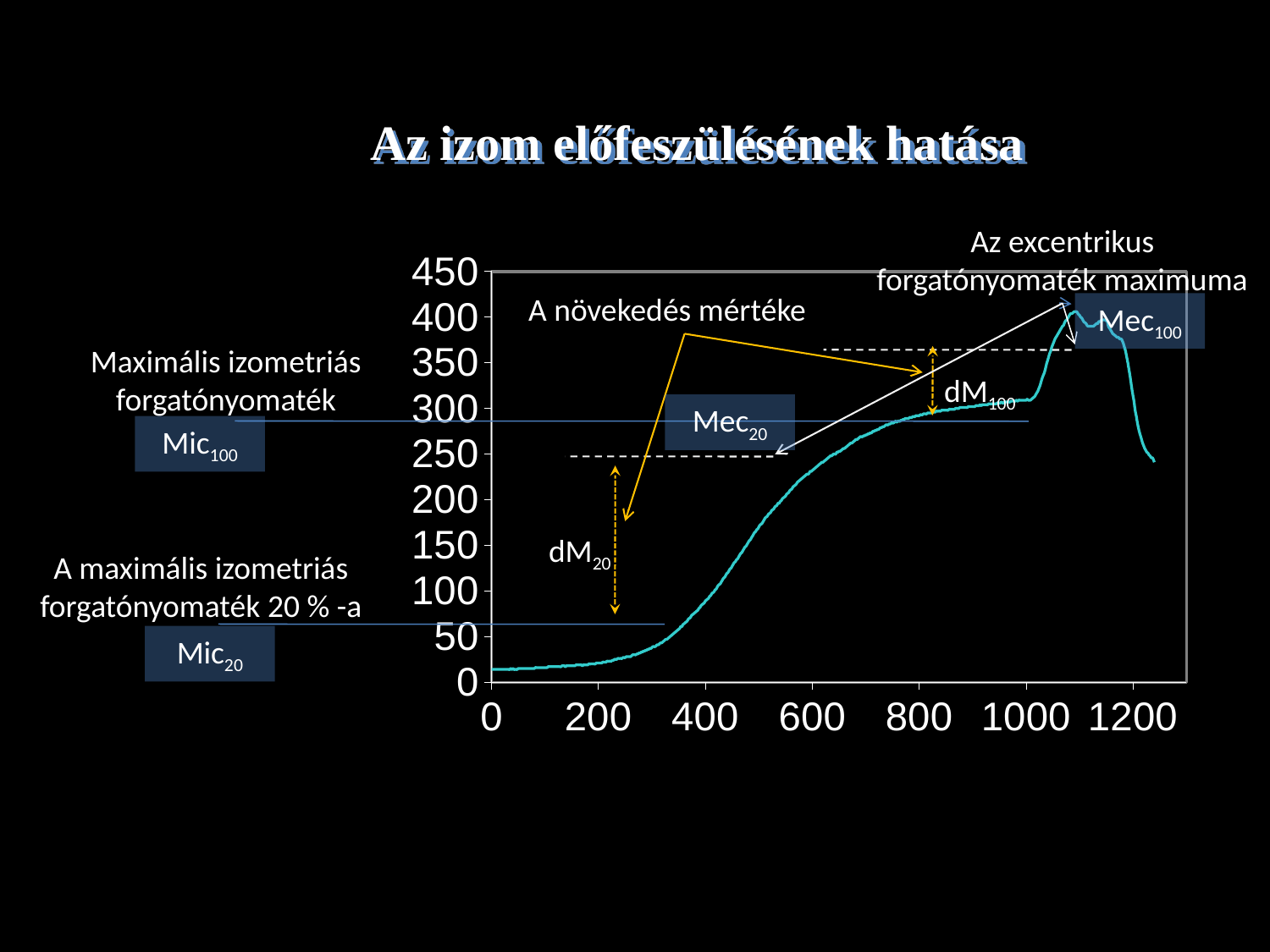
Is the value of the curve at x = 0 greater or less than 50? less Is the peak value of the curve greater or less than 350? greater Is the value of the curve at x = 600 greater or less than 200? greater What kind of chart is shown on the slide? line chart Does the curve rise or fall between x = 400 and x = 800? rise Which is larger, the value of the curve at x = 400 or at x = 1000? x = 1000 What is the title of the slide containing the chart? Az izom előfeszülésének hatása What is the highest value shown on the vertical axis of the chart? 450 Does the curve rise or fall after its peak near x = 1100? fall How many tick labels are shown on the horizontal axis of the chart? 7